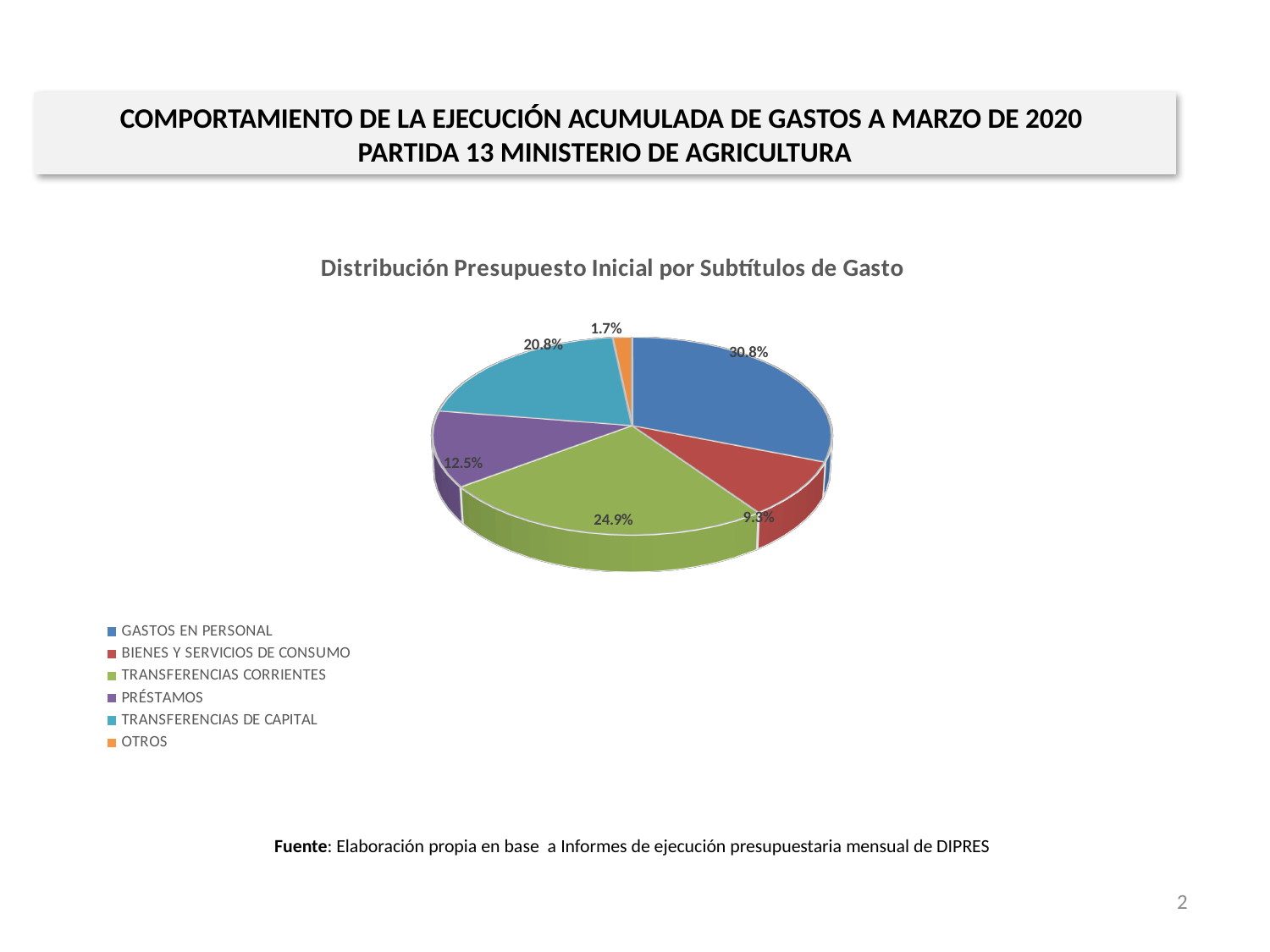
What is the title of the chart? Distribución Presupuesto Inicial por Subtítulos de Gasto What share of the pie does OTROS represent? 1.7% What share of the pie does PRÉSTAMOS represent? 12.5% Which category has the largest share of the pie? GASTOS EN PERSONAL Which is larger, TRANSFERENCIAS DE CAPITAL or PRÉSTAMOS? TRANSFERENCIAS DE CAPITAL What share of the pie does GASTOS EN PERSONAL represent? 30.8% What kind of chart is shown on the slide? Pie chart What share of the pie does TRANSFERENCIAS CORRIENTES represent? 24.9% How many categories does the legend list? 6 What colour is the slice for TRANSFERENCIAS CORRIENTES? Green What is the difference in percentage points between GASTOS EN PERSONAL and BIENES Y SERVICIOS DE CONSUMO? 21.5 Which category has the smallest share of the pie? OTROS